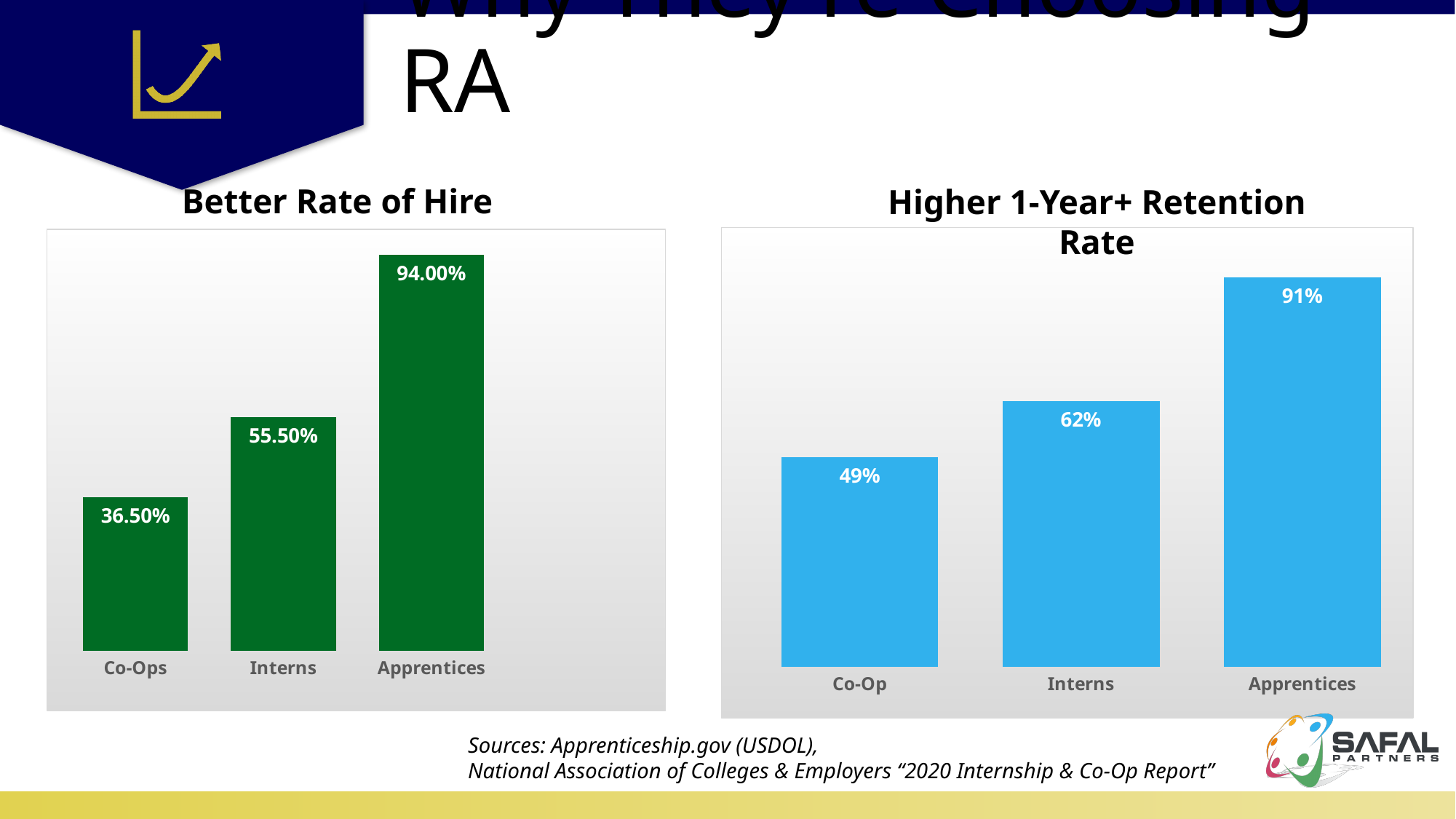
In the 'Higher 1-Year+ Retention Rate' chart, which is larger, the value for Interns or the value for Apprentices? Apprentices In the 'Higher 1-Year+ Retention Rate' chart, what is the difference between the values for Apprentices and Co-Op? 42% What kind of chart is the 'Higher 1-Year+ Retention Rate' chart? Bar chart In the 'Higher 1-Year+ Retention Rate' chart, what is the value for Interns? 62% In the 'Better Rate of Hire' chart, what is the value for Co-Ops? 36.50% What colour are the bars in the 'Higher 1-Year+ Retention Rate' chart? Blue In the 'Better Rate of Hire' chart, do the values rise or fall from Co-Ops to Apprentices? Rise How many categories are shown in the 'Better Rate of Hire' chart? 3 In the 'Better Rate of Hire' chart, which category has the highest value? Apprentices In the 'Better Rate of Hire' chart, what is the value for Apprentices? 94.00% In the 'Higher 1-Year+ Retention Rate' chart, which category has the lowest value? Co-Op In the 'Better Rate of Hire' chart, what is the difference between the values for Interns and Co-Ops? 19.00%